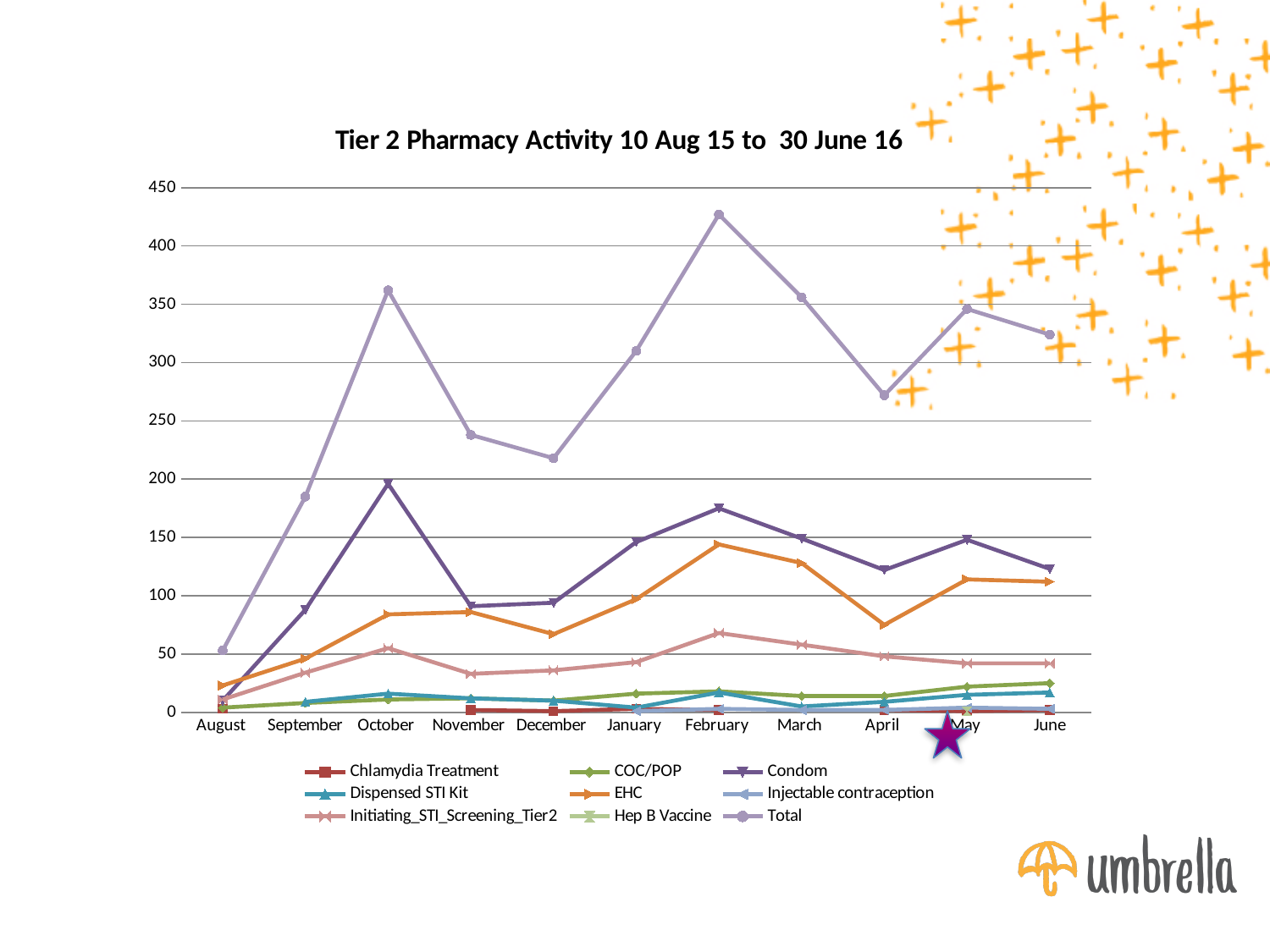
Is the Total value for December greater or less than 250? less Is the Total value for February greater or less than 400? greater Is the EHC value for April greater or less than 100? less How many series does the legend list? 9 In which month does the Condom series reach its highest value? October How many months are shown along the x axis? 11 What is the title of the chart? Tier 2 Pharmacy Activity 10 Aug 15 to 30 June 16 In which month is the Total series at its lowest value? August Does the Total series rise or fall from August to October? rise What kind of chart is shown on the slide? line chart Which is larger in October, the Condom value or the EHC value? Condom In which month does the Total series reach its highest value? February